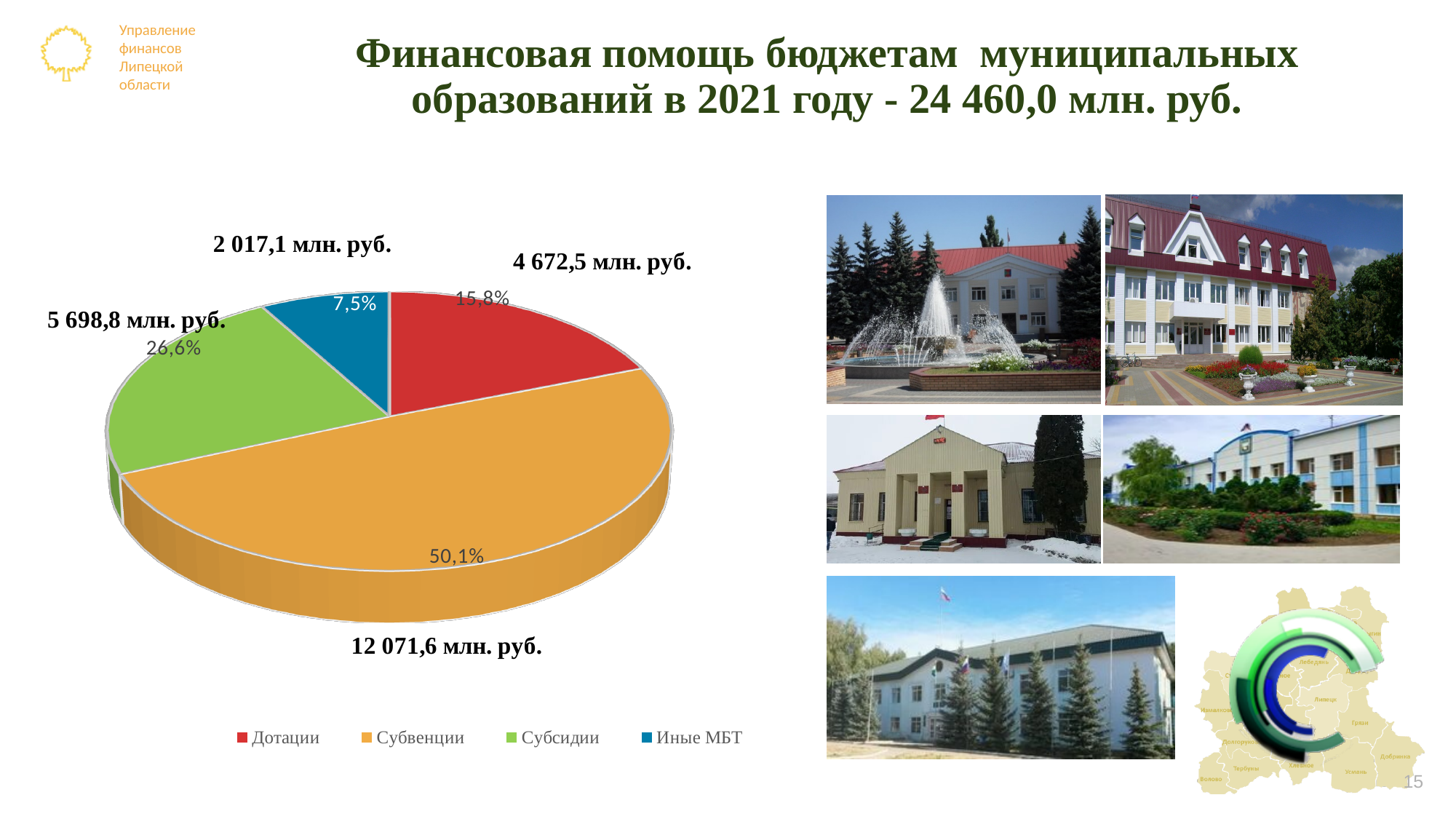
What is the value for Субвенции? 12 071,6 млн. руб. How many categories does the pie chart show? 4 What is the value for Дотации? 4 672,5 млн. руб. Which category has the largest share of the pie? Субвенции Which category has the smallest share of the pie? Иные МБТ What share of the pie does Субсидии represent? 26,6% What is the value for Иные МБТ? 2 017,1 млн. руб. What share of the pie does Дотации represent? 15,8% What colour is the Иные МБТ slice? Blue What is the value for Субсидии? 5 698,8 млн. руб. What kind of chart is shown on the slide? Pie chart Which is larger, Субсидии or Дотации? Субсидии